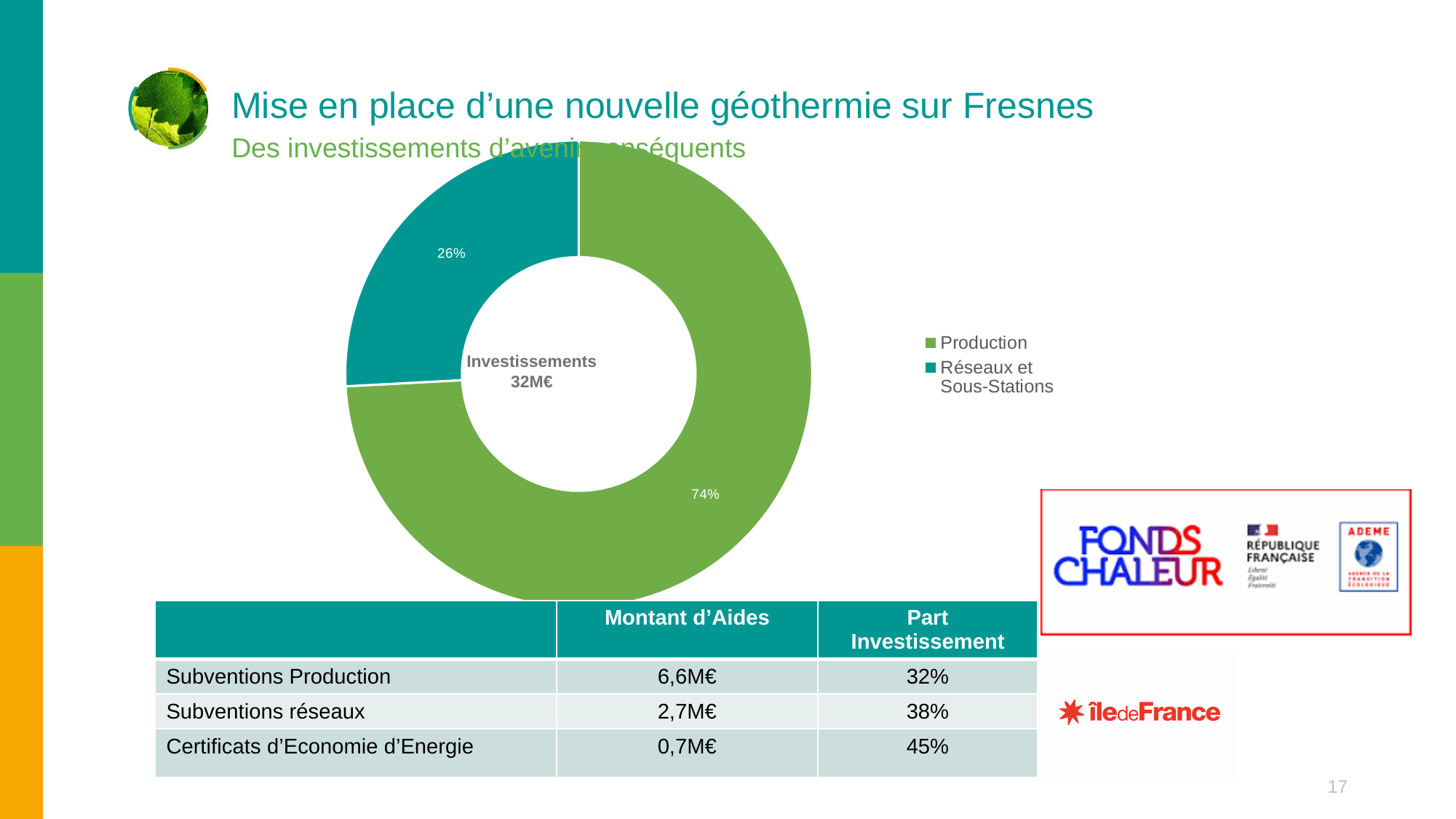
Which is larger: the share for Production or the share for Réseaux et Sous-Stations? Production What share of the investments does Production represent? 74% How many categories does the doughnut chart show? 2 Which category has the largest share of the investments? Production What colour is the Production segment of the doughnut chart? Green What kind of chart is shown on the slide? Doughnut chart How many entries does the chart legend list? 2 What total investment amount is shown in the centre of the doughnut chart? 32M€ Which category has the smallest share of the investments? Réseaux et Sous-Stations What share of the investments does Réseaux et Sous-Stations represent? 26% What is the difference in percentage points between the Production share and the Réseaux et Sous-Stations share? 48 percentage points